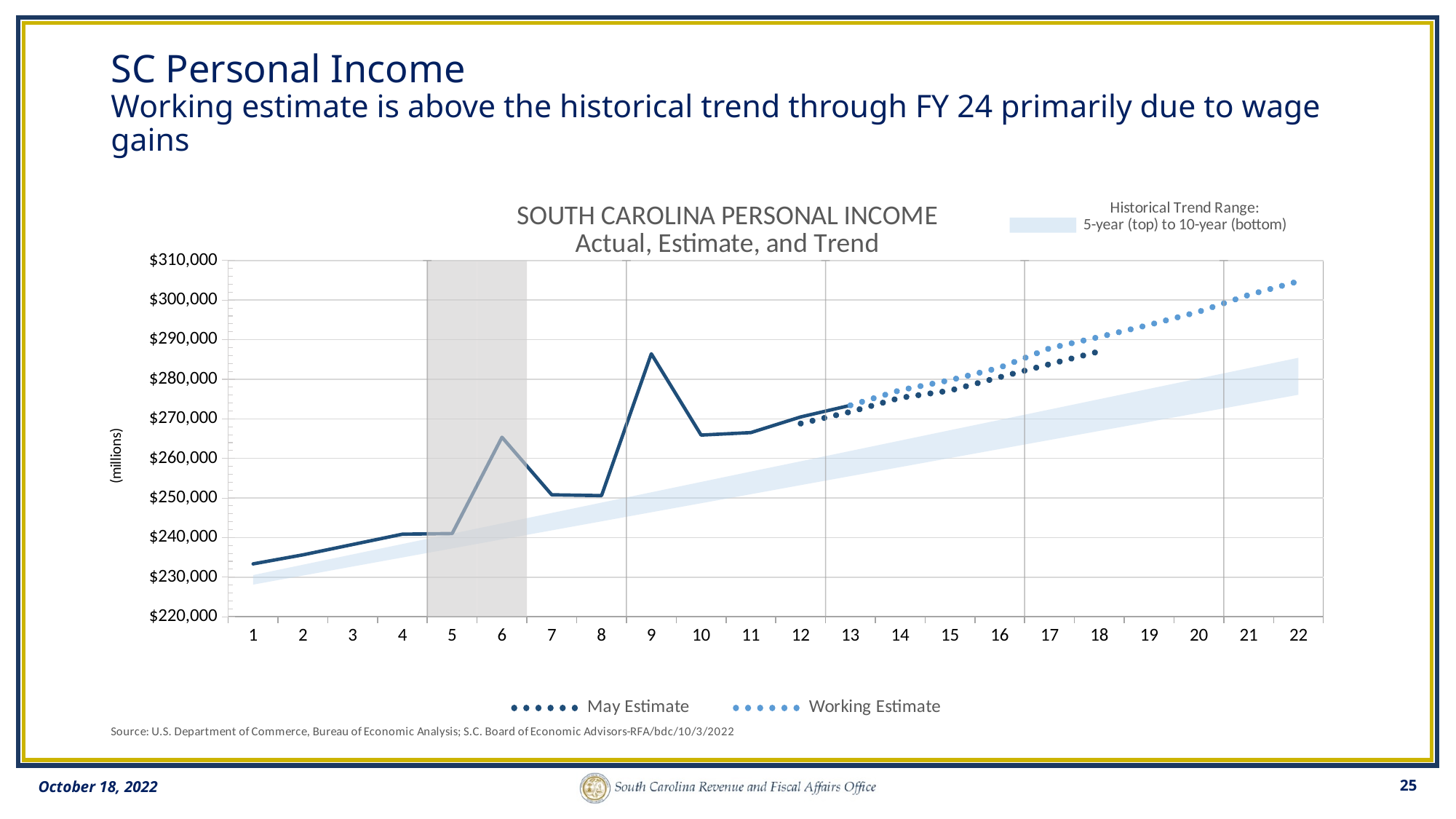
How many points are labelled along the x axis? 22 What kind of chart is shown on the slide? Line chart At which x-axis point does the solid line reach its highest value? 9 At point 18, which is higher: the May Estimate or the Working Estimate? Working Estimate Is the value of the solid line at point 1 greater or less than $230,000? greater Is the May Estimate value at point 18 greater or less than $290,000? less Do the values generally rise or fall from point 1 to point 22? Rise Is the value of the solid line at point 10 greater or less than $270,000? less What is the title of the chart? SOUTH CAROLINA PERSONAL INCOME Actual, Estimate, and Trend How many series does the legend at the bottom of the chart list? 2